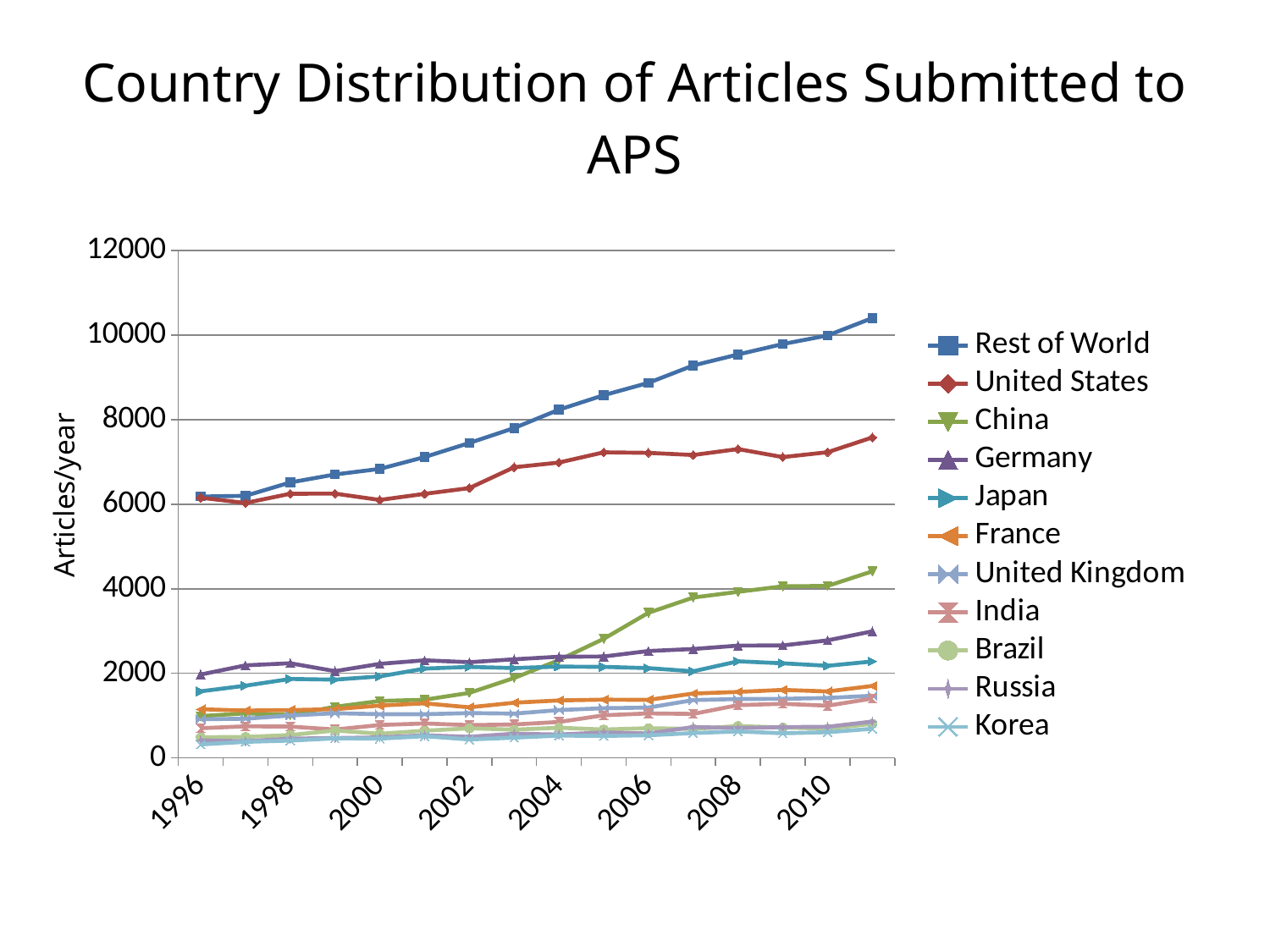
What is the title of the chart? Country Distribution of Articles Submitted to APS Does the Rest of World series generally rise or fall from 1996 to 2011? rise Is the value for Rest of World in 2008 greater or less than 8000? greater Is the value for United States in 2010 greater or less than 6000? greater How many series does the legend list? 11 What kind of chart is shown on the slide? line chart Is the value for China in 2002 greater or less than 2000? less Which series has the highest value in 2010? Rest of World What is the label on the vertical axis? Articles/year Which is larger in 2010, the value for China or the value for Germany? China Which series has the lowest value in 1996? Korea Which is larger in 1996, the value for Germany or the value for China? Germany